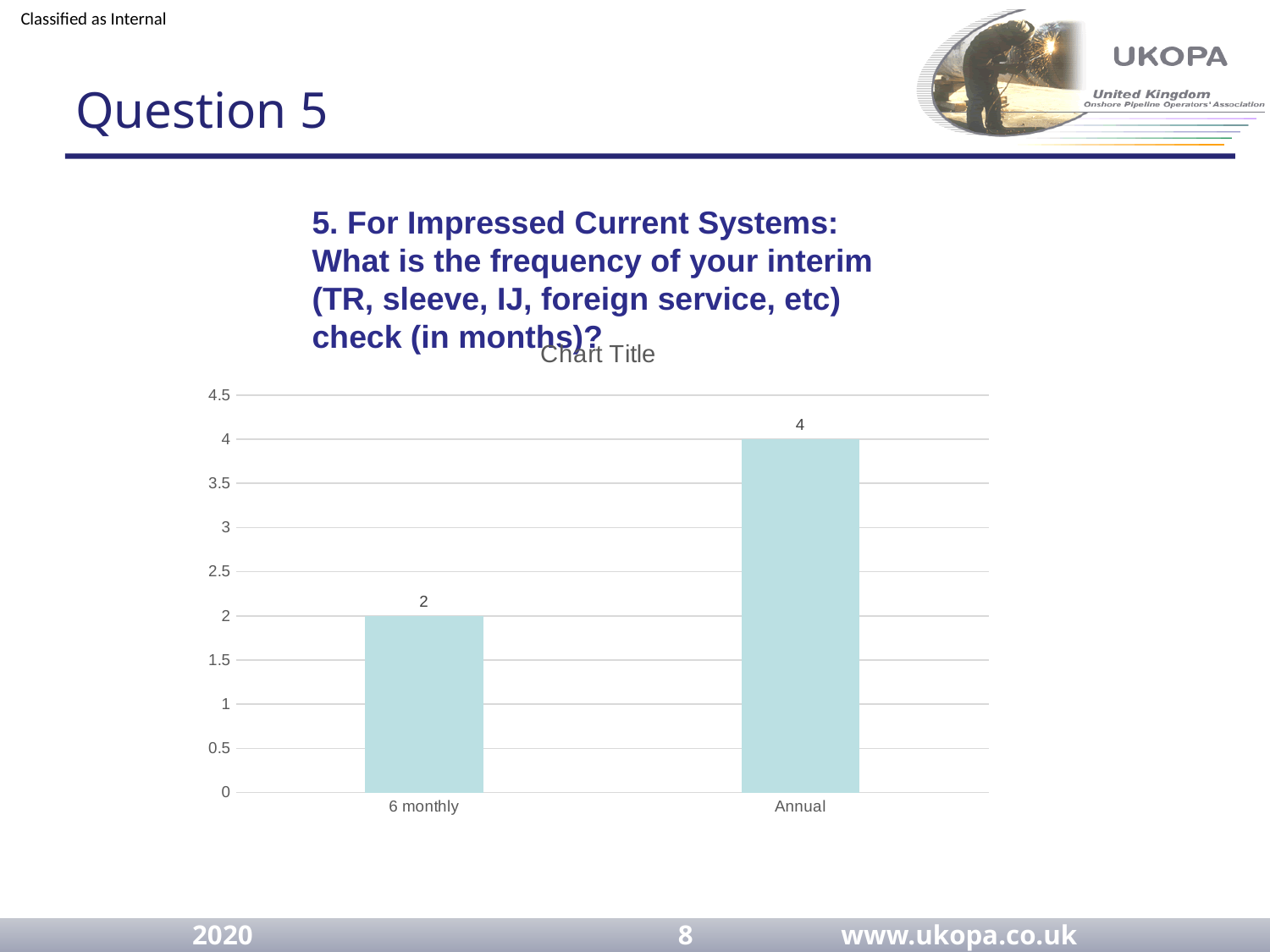
Which category has the lowest value? 6 monthly Do the values rise or fall from '6 monthly' to 'Annual'? rise What kind of chart is shown on the slide? bar chart Is the value for 'Annual' greater or less than 3? greater How many categories are shown on the x axis? 2 Is the value for '6 monthly' greater or less than 3? less What is the title shown above the chart? Chart Title Which category has the highest value? Annual Which is larger, the value for '6 monthly' or the value for 'Annual'? Annual What is the value for the '6 monthly' category? 2 What is the difference between the values for 'Annual' and '6 monthly'? 2 What is the value for the 'Annual' category? 4